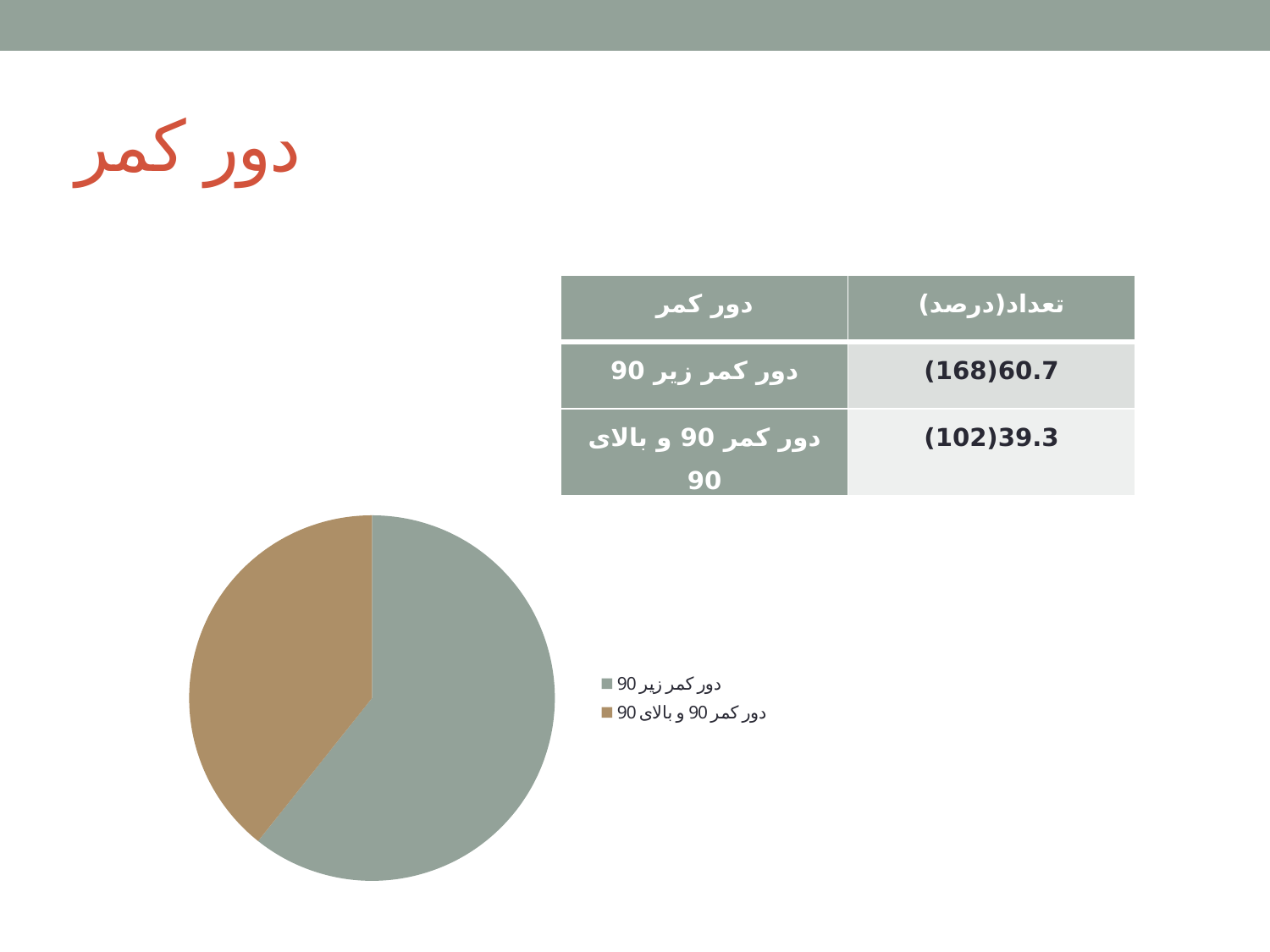
Which category has the smallest slice in the pie chart? دور کمر 90 و بالای 90 In the pie chart, which slice is larger: دور کمر زیر 90 or دور کمر 90 و بالای 90? دور کمر زیر 90 How many slices does the pie chart have? 2 What is the title of the slide? دور کمر According to the table on the slide, what percentage is shown for دور کمر زیر 90? 60.7 According to the table on the slide, what is the count for دور کمر 90 و بالای 90? 102 Which category has the largest slice in the pie chart? دور کمر زیر 90 How many entries does the pie chart's legend list? 2 What colour is the slice for دور کمر 90 و بالای 90 in the pie chart? brown According to the table on the slide, what is the count for دور کمر زیر 90? 168 According to the table on the slide, what percentage is shown for دور کمر 90 و بالای 90? 39.3 What kind of chart is shown on the slide? pie chart